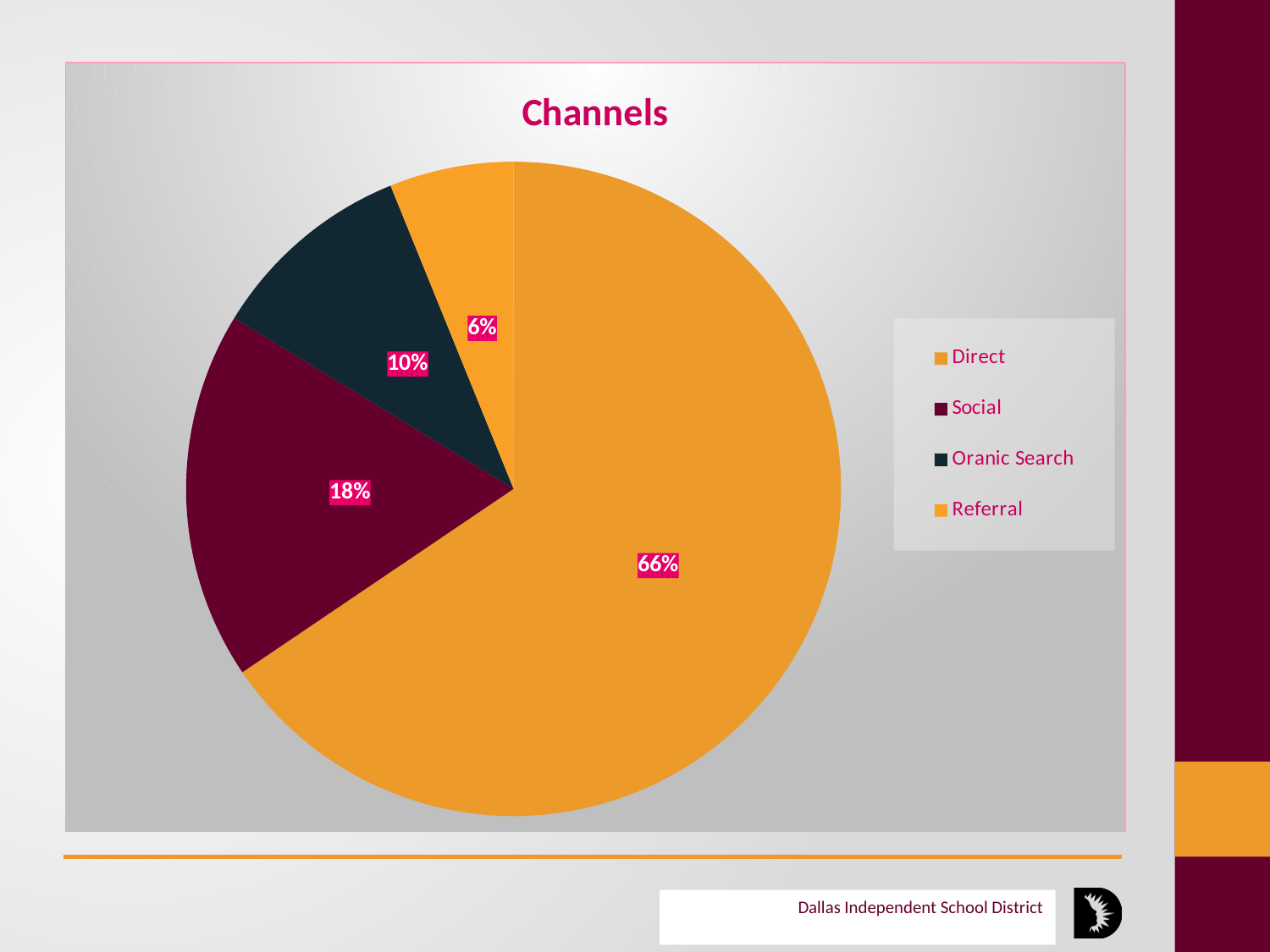
What share of the pie does Direct account for? 66% Which is larger, the Social slice or the Oranic Search slice? Social What kind of chart is shown on the slide? pie chart What share of the pie does Social account for? 18% What is the difference in percentage points between Direct and Social? 48 How many entries does the legend list? 4 How many slices does the pie chart have? 4 Which channel has the smallest slice of the pie? Referral What share of the pie does Referral account for? 6% Which channel has the largest slice of the pie? Direct What is the title of the chart? Channels